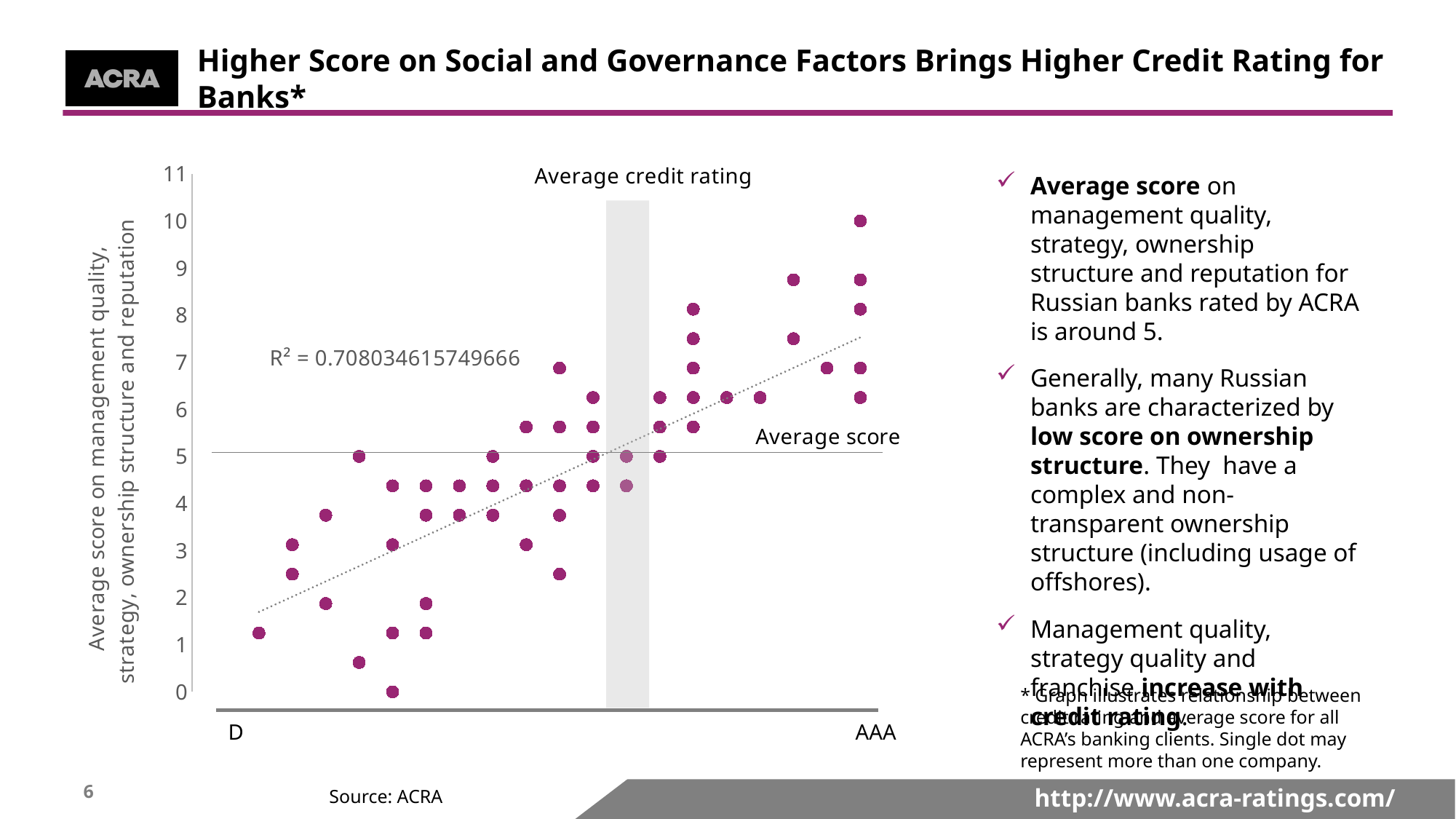
What is the lowest average score plotted on the chart? 0 What kind of chart is shown on the slide? scatter chart What is the highest tick value shown on the y axis? 11 What does the horizontal line across the chart represent? Average score Is the lowest plotted point greater or less than 1? less Do the average scores generally rise or fall as the credit rating moves from D to AAA? rise What R² value is printed on the chart? R² = 0.708034615749666 Is the highest plotted point greater or less than 9? greater What is the highest average score plotted on the chart? 10 What does the shaded vertical band on the chart represent? Average credit rating